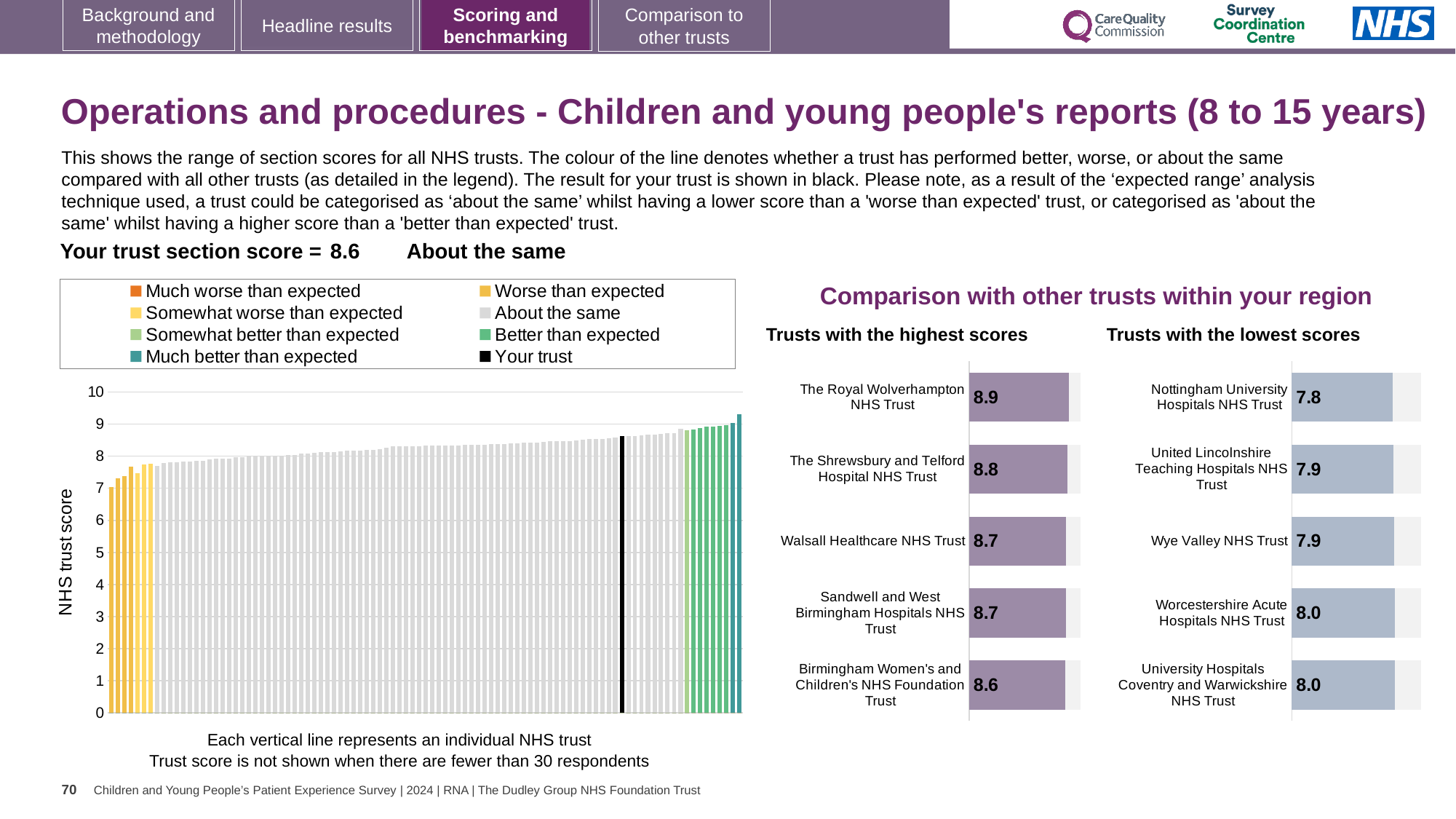
In the 'Trusts with the lowest scores' chart, what is the score for Nottingham University Hospitals NHS Trust? 7.8 In the 'Trusts with the lowest scores' chart, which has the larger score: Nottingham University Hospitals NHS Trust or Worcestershire Acute Hospitals NHS Trust? Worcestershire Acute Hospitals NHS Trust How many trusts are shown in the 'Trusts with the highest scores' chart? 5 In the 'Trusts with the highest scores' chart, what is the score for The Royal Wolverhampton NHS Trust? 8.9 In the 'Trusts with the highest scores' chart, what is the score for Walsall Healthcare NHS Trust? 8.7 In the 'Trusts with the highest scores' chart, what is the difference between the scores of The Royal Wolverhampton NHS Trust and Birmingham Women's and Children's NHS Foundation Trust? 0.3 How many entries does the legend of the main 'NHS trust score' chart on the left list? 8 In the 'Trusts with the lowest scores' chart, which trust has the lowest score? Nottingham University Hospitals NHS Trust In the main 'NHS trust score' chart on the left, is the value for the black 'Your trust' bar greater or less than 8? greater What kind of chart is the main 'NHS trust score' chart on the left? bar chart In the 'Trusts with the lowest scores' chart, what is the score for Wye Valley NHS Trust? 7.9 In the 'Trusts with the highest scores' chart, which trust has the highest score? The Royal Wolverhampton NHS Trust